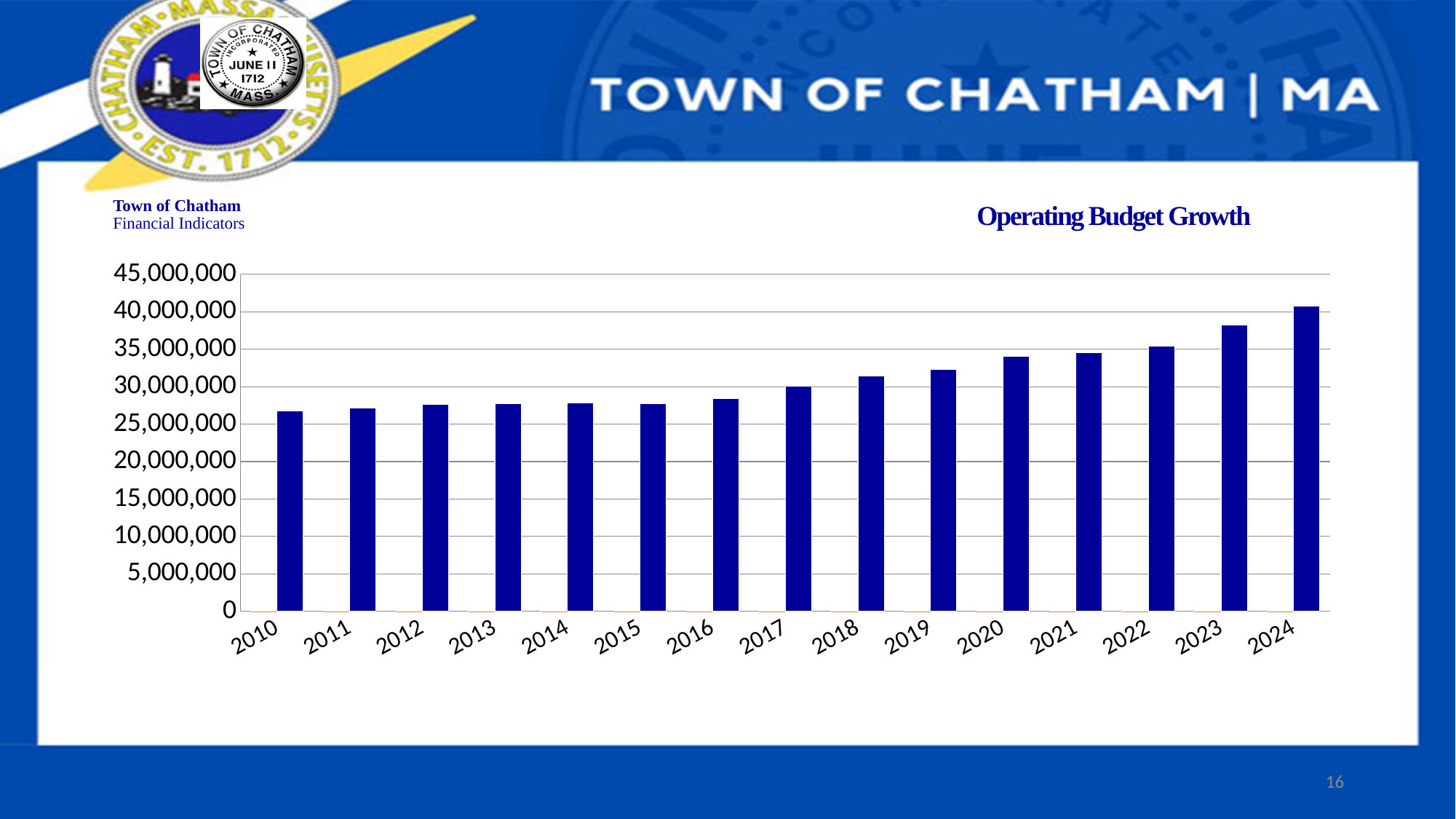
How many years are shown on the x axis of the chart? 15 Is the value for 2010 greater or less than 25,000,000? greater Which year has the highest operating budget in the chart? 2024 Is the value for 2023 greater or less than 35,000,000? greater Is the value for 2016 greater or less than 30,000,000? less What is the title of the chart? Operating Budget Growth Which is larger, the value for 2023 or the value for 2020? 2023 Do the operating budget values generally rise or fall from 2010 to 2024? Rise What kind of chart is shown on the slide? Bar chart Which is larger, the value for 2013 or the value for 2017? 2017